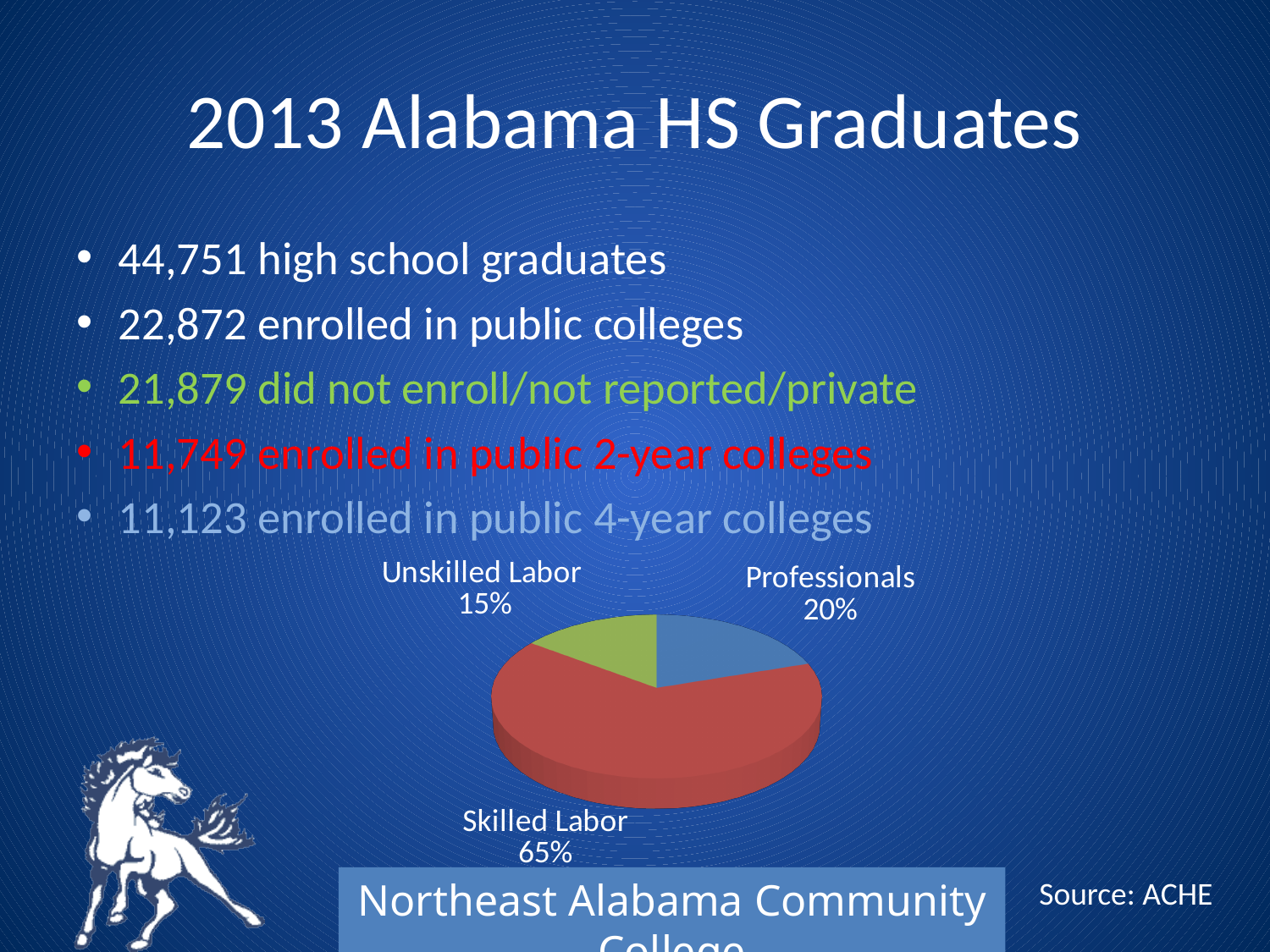
What is the difference in percentage points between the Skilled Labor and Professionals slices? 45 Which is larger in the pie chart, Professionals or Unskilled Labor? Professionals What share of the pie chart is Professionals? 20% What colour is the Unskilled Labor slice of the pie chart? Green What share of the pie chart is Skilled Labor? 65% What colour is the Skilled Labor slice of the pie chart? Red Which slice of the pie chart is the smallest? Unskilled Labor Which slice of the pie chart is the largest? Skilled Labor How many slices does the pie chart have? 3 What share of the pie chart is Unskilled Labor? 15% What kind of chart is shown on the slide? Pie chart What is the difference in percentage points between the Professionals and Unskilled Labor slices? 5